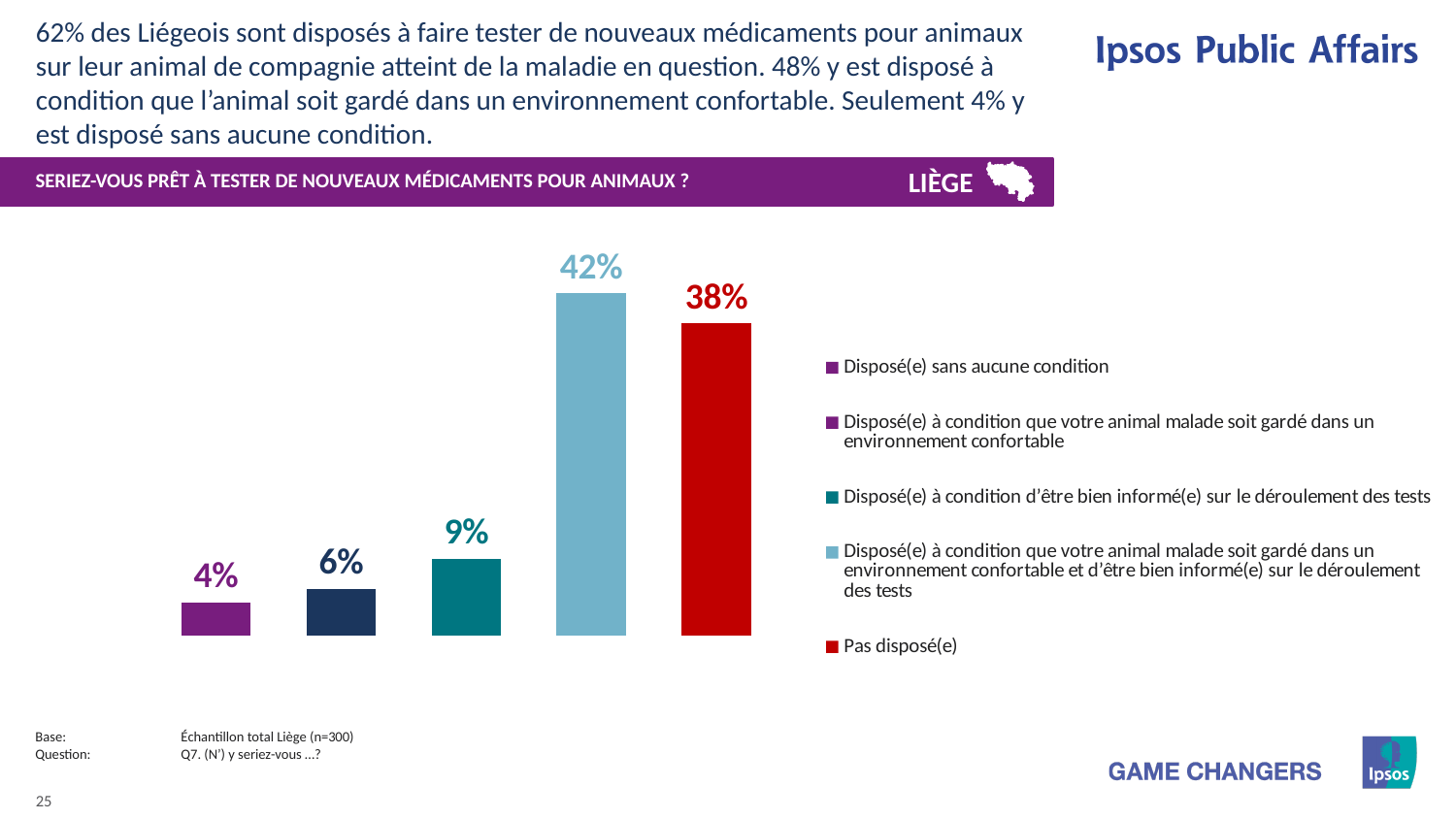
What colour is the bar for 'Pas disposé(e)'? Red How many bars are shown in the chart? 5 How many entries does the legend list? 5 What type of chart is shown on the slide? Bar chart Which is larger: the value for 'Pas disposé(e)' or the value for the category with both conditions (comfortable environment and being well informed)? The category with both conditions (42%) What percentage of respondents are 'Disposé(e) à condition que votre animal malade soit gardé dans un environnement confortable'? 6% What percentage of respondents are 'Disposé(e) sans aucune condition'? 4% What percentage of respondents are 'Pas disposé(e)'? 38% Which category has the lowest value in the chart? Disposé(e) sans aucune condition What percentage of respondents are 'Disposé(e) à condition d'être bien informé(e) sur le déroulement des tests'? 9% Which category has the highest value in the chart? Disposé(e) à condition que votre animal malade soit gardé dans un environnement confortable et d'être bien informé(e) sur le déroulement des tests What is the difference between the value for 'Pas disposé(e)' and the value for 'Disposé(e) sans aucune condition'? 34%